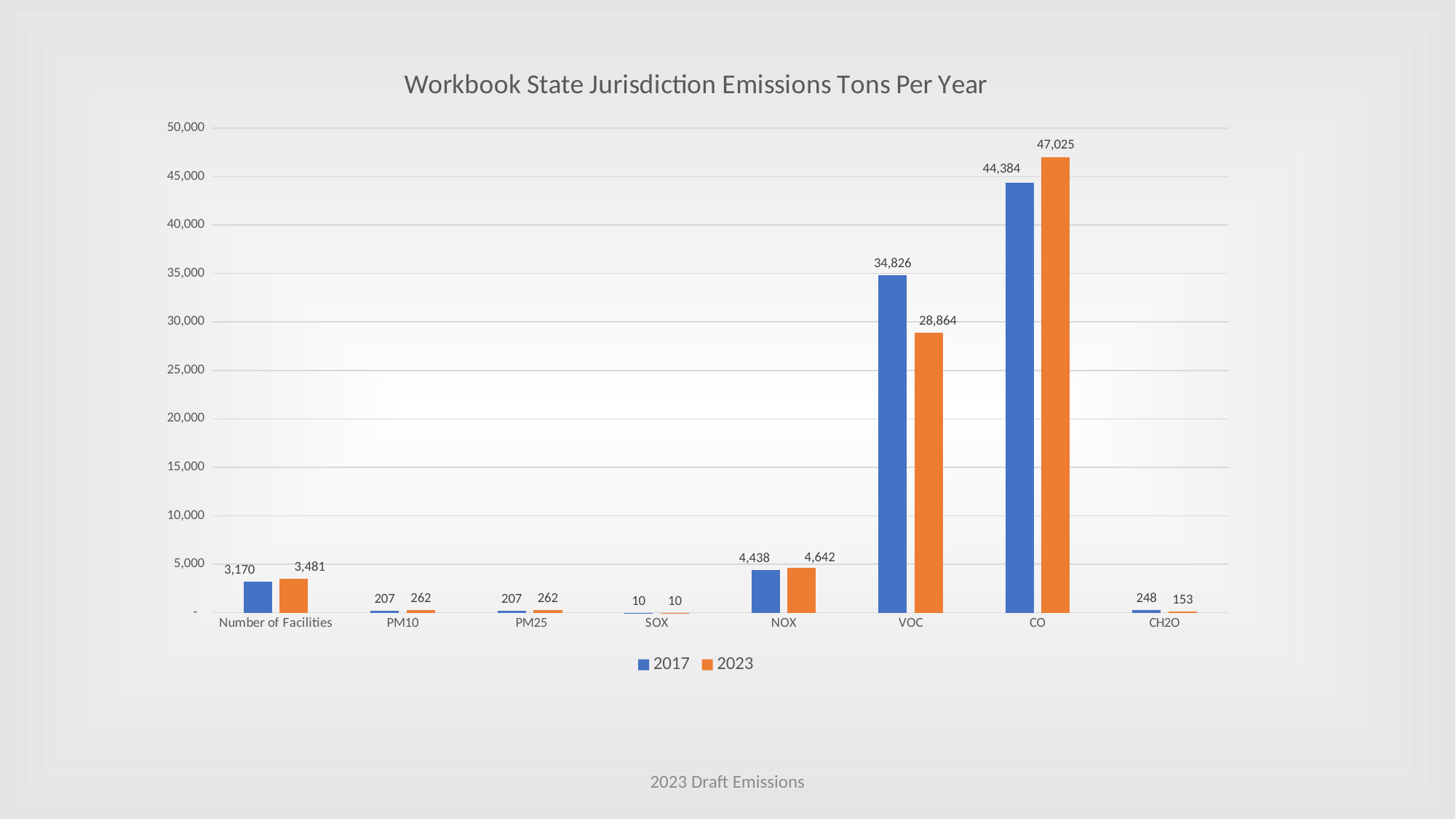
How many categories are shown on the x axis? 8 What is the difference between the 2023 and 2017 values for CO? 2,641 Which is larger for NOX, the 2017 value or the 2023 value? 2023 What is the 2017 value for VOC? 34,826 Which category has the lowest 2023 value? SOX Which category has the highest 2017 value? CO What is the 2023 value for CO? 47,025 What is the difference between the 2017 and 2023 values for VOC? 5,962 Is the 2023 value for VOC greater or less than 30,000? less What type of chart is shown? bar chart How many series does the legend list? 2 What is the 2023 value for CH2O? 153